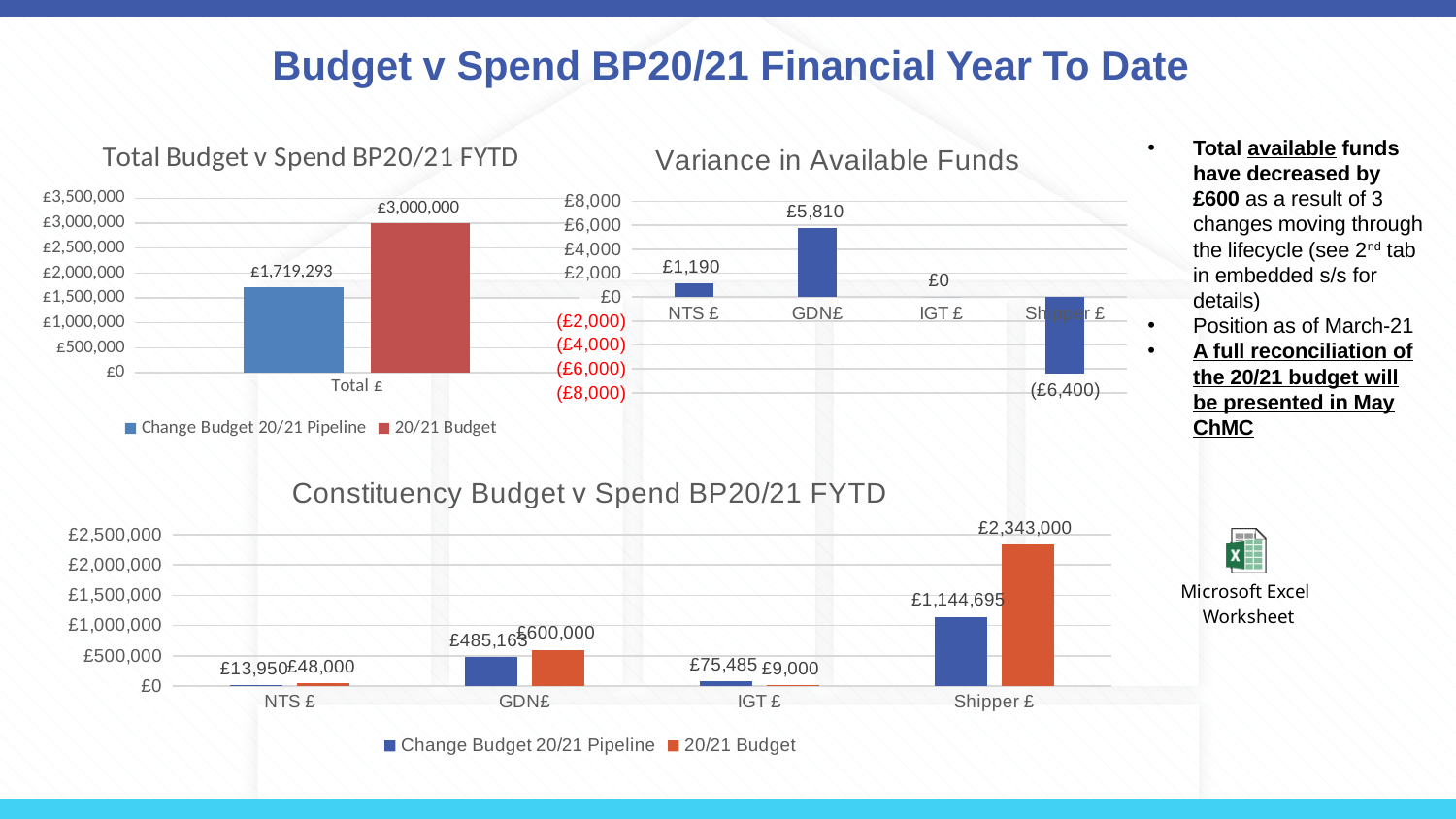
In the 'Constituency Budget v Spend BP20/21 FYTD' chart, which is larger for IGT £: Change Budget 20/21 Pipeline or 20/21 Budget? Change Budget 20/21 Pipeline What kind of chart is the 'Constituency Budget v Spend BP20/21 FYTD' chart? Bar chart In the 'Constituency Budget v Spend BP20/21 FYTD' chart, what is the difference between the 20/21 Budget and the Change Budget 20/21 Pipeline for Shipper £? £1,198,305 In the 'Variance in Available Funds' chart, what is the value for Shipper £? (£6,400) In the 'Variance in Available Funds' chart, what is the value for GDN£? £5,810 In the 'Total Budget v Spend BP20/21 FYTD' chart, what is the value of Change Budget 20/21 Pipeline for Total £? £1,719,293 In the 'Constituency Budget v Spend BP20/21 FYTD' chart, what is the 20/21 Budget value for Shipper £? £2,343,000 In the 'Total Budget v Spend BP20/21 FYTD' chart, what is the value of 20/21 Budget for Total £? £3,000,000 In the 'Variance in Available Funds' chart, which category has the highest value? GDN£ In the 'Total Budget v Spend BP20/21 FYTD' chart, how many series does the legend list? 2 In the 'Variance in Available Funds' chart, how many categories are shown on the x axis? 4 In the 'Constituency Budget v Spend BP20/21 FYTD' chart, what is the Change Budget 20/21 Pipeline value for GDN£? £485,163